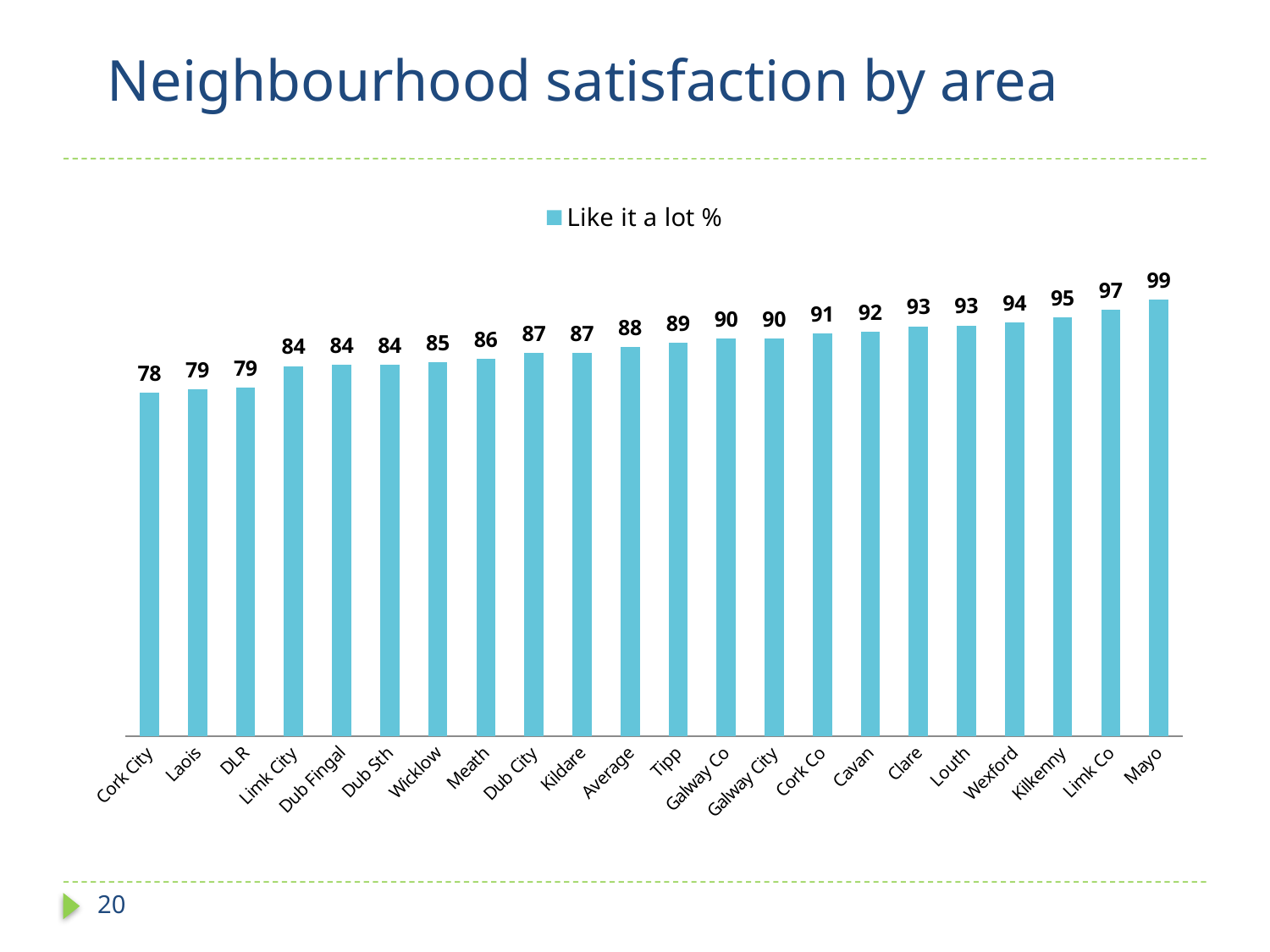
How many series does the legend list? 1 What is the value shown for Wexford? 94 What kind of chart is shown on the slide? Bar chart What is the 'Like it a lot %' value for Mayo? 99 How many areas (bars) are shown on the chart? 22 Do the values rise or fall from left to right along the x axis? Rise What is the value shown for Average? 88 Which area has the highest 'Like it a lot %' value? Mayo What is the difference between the values for Mayo and Cork City? 21 Which area has the lowest 'Like it a lot %' value? Cork City Which has a higher value, Kilkenny or Meath? Kilkenny What is the 'Like it a lot %' value for Cork City? 78